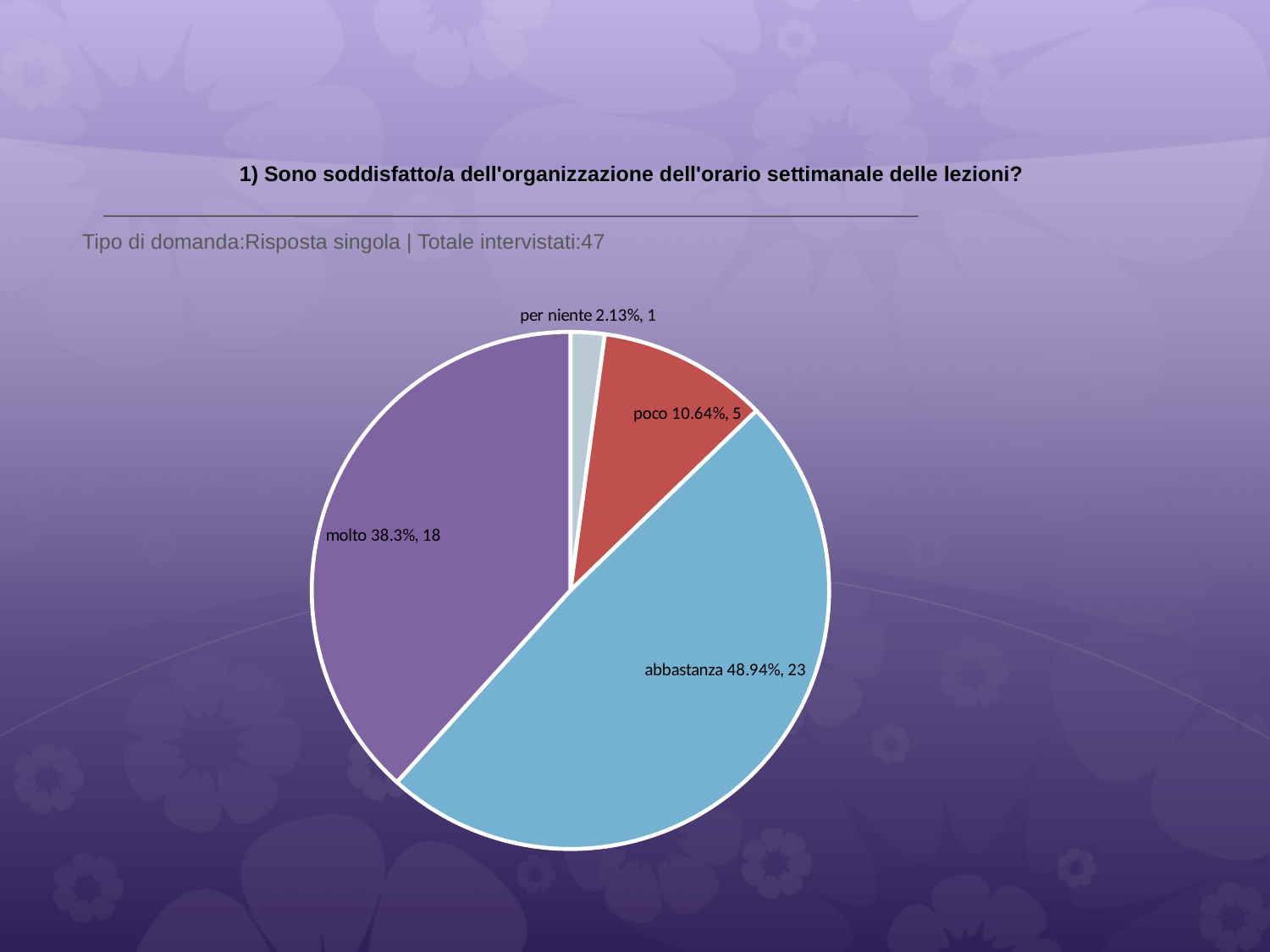
What is the difference in number of respondents between "abbastanza" and "molto"? 5 Which response has the largest share of the pie? abbastanza What is the total number of respondents shown on the slide? 47 How many respondents answered "molto"? 18 Which has more respondents, "poco" or "per niente"? poco What percentage of respondents answered "abbastanza"? 48.94% What colour is the "abbastanza" slice? light blue What percentage of respondents answered "poco"? 10.64% Which response has the smallest share of the pie? per niente What kind of chart is shown on the slide? pie chart How many respondents answered "per niente"? 1 How many slices does the pie chart have? 4